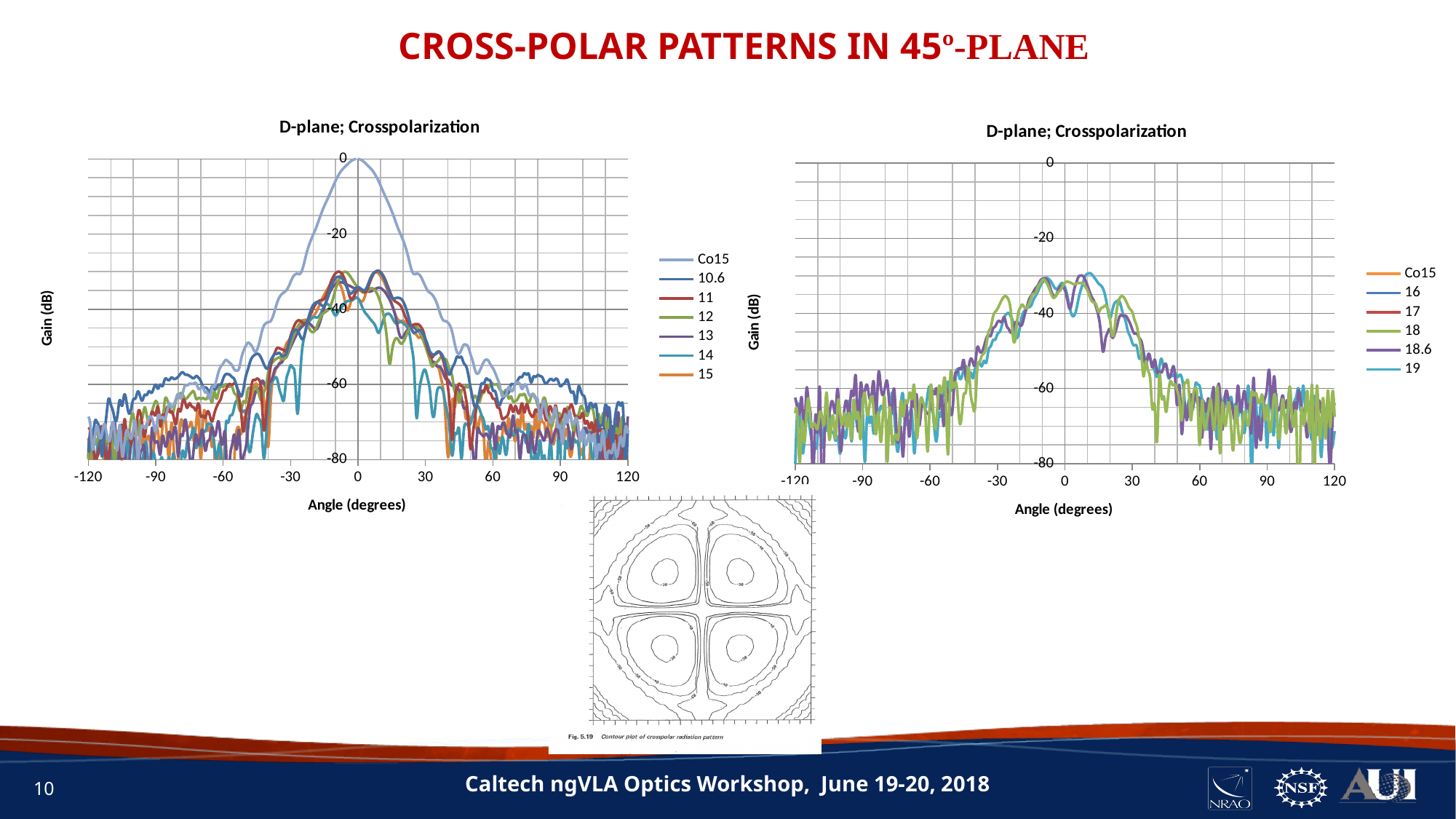
What kind of chart is the left chart titled 'D-plane; Crosspolarization'? line chart What is the label of the vertical axis on the right chart? Gain (dB) How many series does the legend of the right chart list? 6 On the left chart, what is the peak gain of the Co15 series at 0 degrees? 0 On the left chart, is the gain of the 12 series at 0 degrees greater or less than -20? less On the left chart, is the gain of the Co15 series at 0 degrees greater or less than -20? greater On the left chart, which is larger at 0 degrees: the gain of Co15 or the gain of 14? Co15 On the right chart, is the gain of the 19 series at 0 degrees greater or less than -40? greater What is the label of the horizontal axis on the left chart? Angle (degrees) How many series does the legend of the left chart list? 7 On the left chart, which series reaches the highest gain? Co15